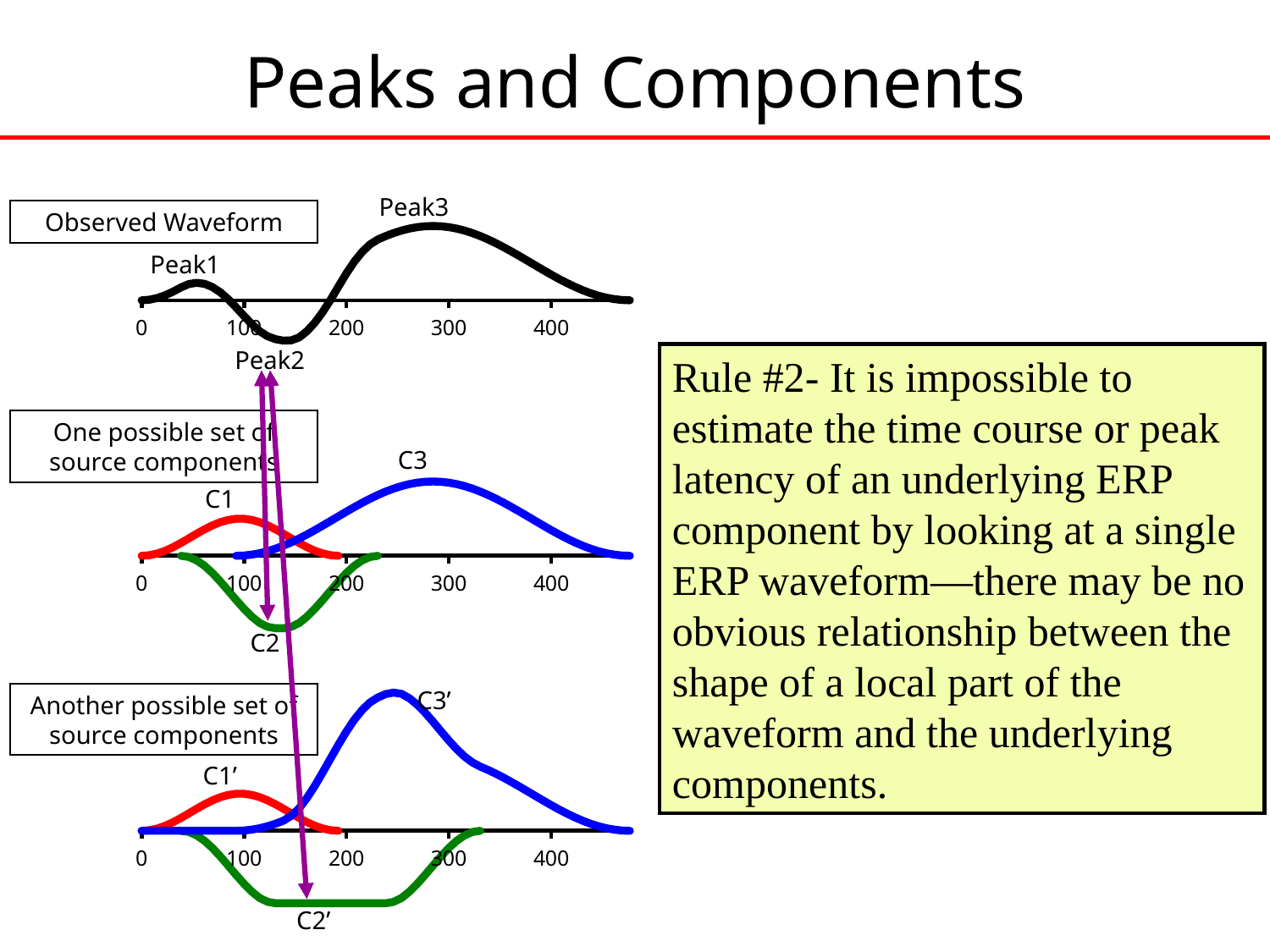
What kind of chart is the 'Observed Waveform' plot? line chart In the 'Observed Waveform' chart, how many peaks are labelled? 3 What is the highest x-axis tick label shown on the 'Observed Waveform' chart? 400 In the 'One possible set of source components' chart, how many components are plotted? 3 In the 'One possible set of source components' chart, which component has the largest positive amplitude? C3 In the 'Observed Waveform' chart, does Peak1 occur at a time greater or less than 100? less In the 'Observed Waveform' chart, which labelled peak is the only negative deflection? Peak2 In the 'Observed Waveform' chart, does Peak3 occur at a time greater or less than 200? greater In the 'One possible set of source components' chart, does the peak of C3 occur at a time greater or less than 200? greater In the 'Observed Waveform' chart, which is larger in amplitude, Peak1 or Peak3? Peak3 In the 'Observed Waveform' chart, which labelled peak has the largest positive amplitude? Peak3 In the 'Another possible set of source components' chart, what colour is the C2' component drawn in? green